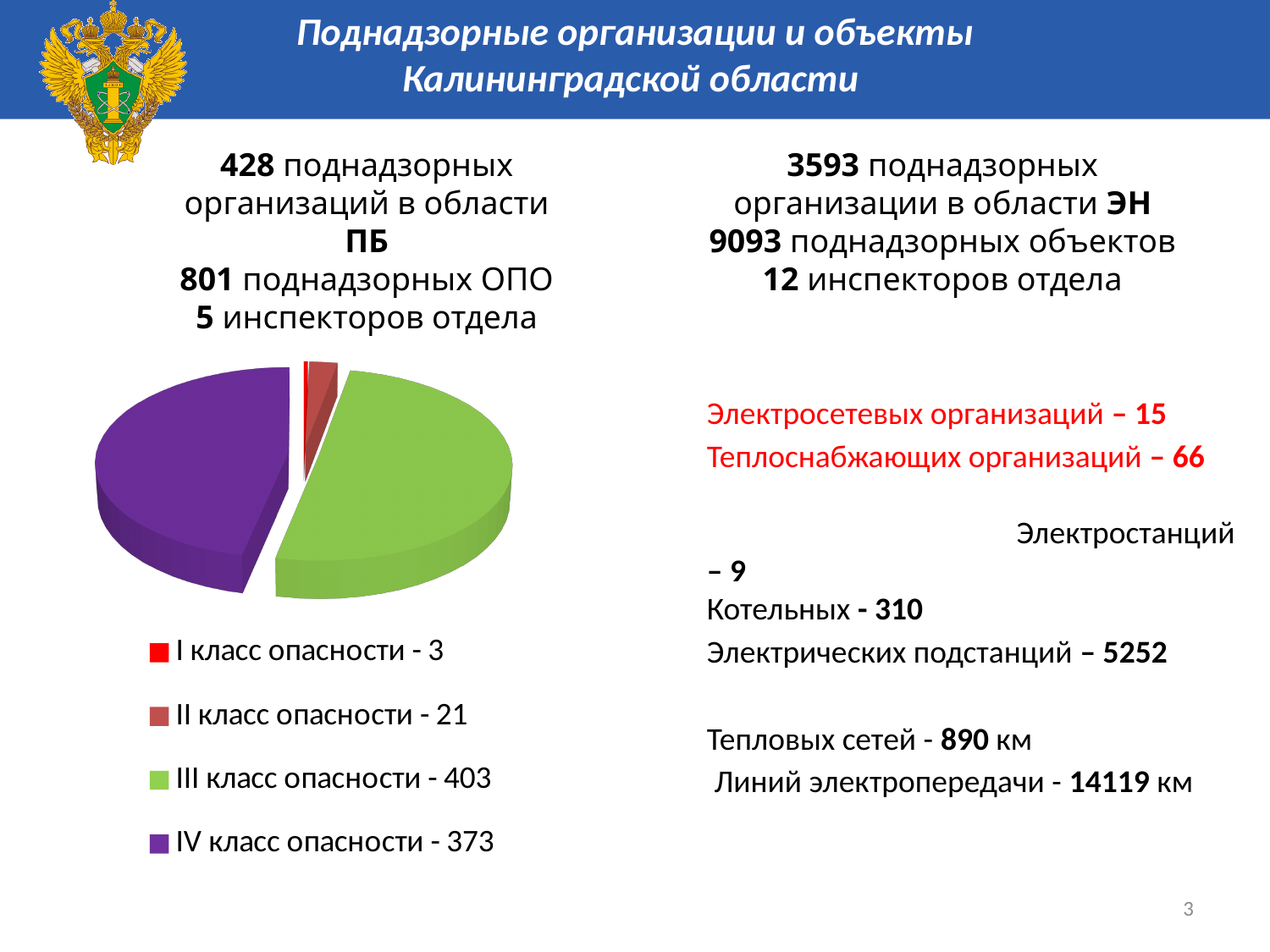
What type of chart is shown on the slide? pie chart What is the difference between the values for II класс опасности and I класс опасности? 18 What is the difference between the values for III класс опасности and IV класс опасности? 30 How many hazard classes (categories) does the pie chart show? 4 What is the value for IV класс опасности in the pie chart? 373 Which hazard class has the largest slice in the pie chart? III класс опасности What is the value for I класс опасности in the pie chart? 3 Which is larger in the pie chart: II класс опасности or IV класс опасности? IV класс опасности Which hazard class has the smallest slice in the pie chart? I класс опасности What is the value for II класс опасности in the pie chart? 21 What colour is the slice for IV класс опасности in the pie chart? purple What is the value for III класс опасности in the pie chart? 403